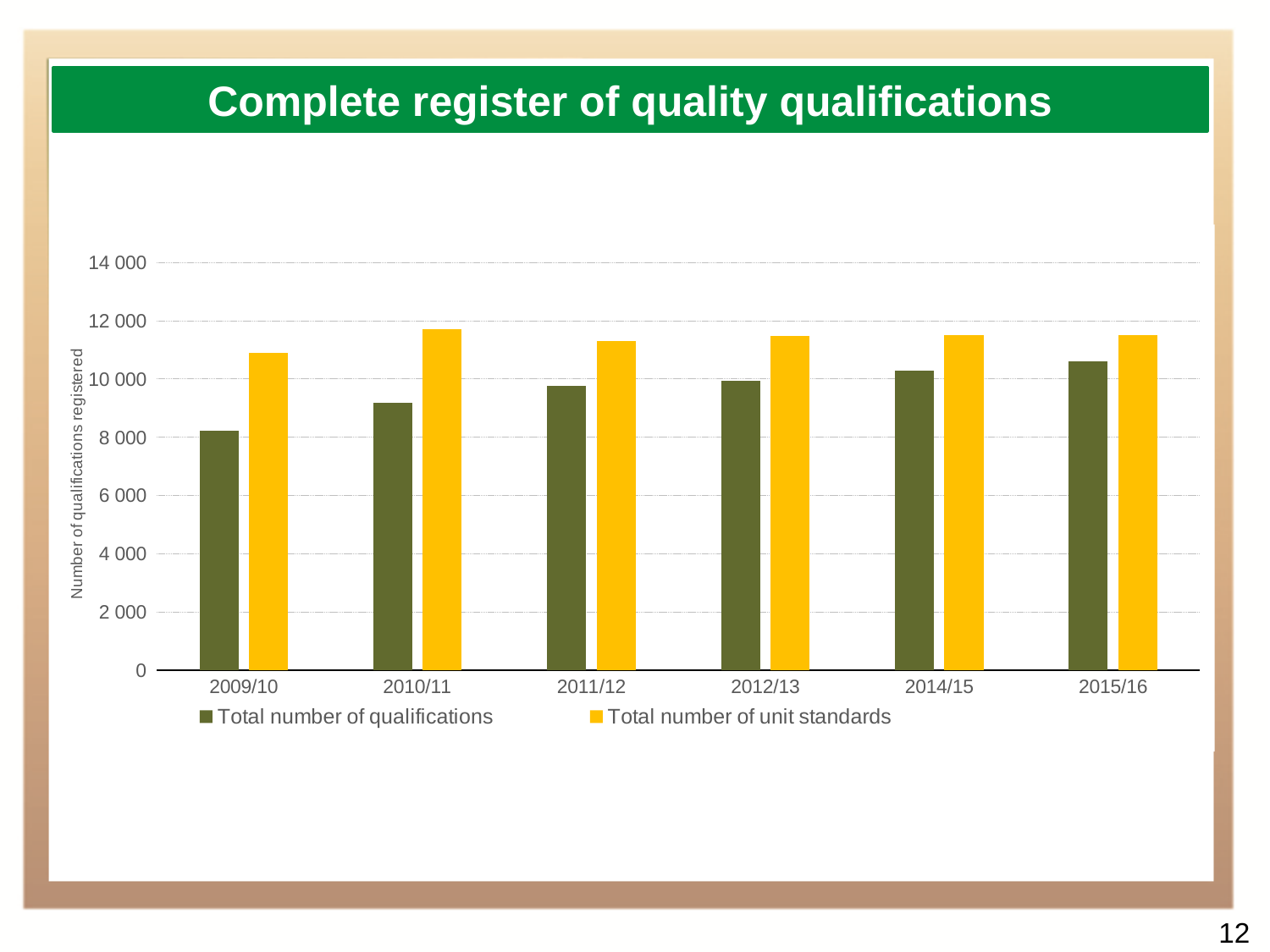
Is the value for Total number of unit standards in 2010/11 greater or less than 12 000? less How many series does the legend list? 2 How many year categories are shown on the x axis? 6 Is the value for Total number of qualifications in 2009/10 greater or less than 10 000? less What kind of chart is shown on the slide? Bar chart What is the label on the vertical axis of the chart? Number of qualifications registered Which year has the lowest value for Total number of qualifications? 2009/10 Does the Total number of qualifications rise or fall from 2009/10 to 2015/16? Rise Which year has the lowest value for Total number of unit standards? 2009/10 Which year has the highest value for Total number of qualifications? 2015/16 In 2009/10, which is larger: Total number of qualifications or Total number of unit standards? Total number of unit standards Is the value for Total number of qualifications in 2015/16 greater or less than 10 000? greater